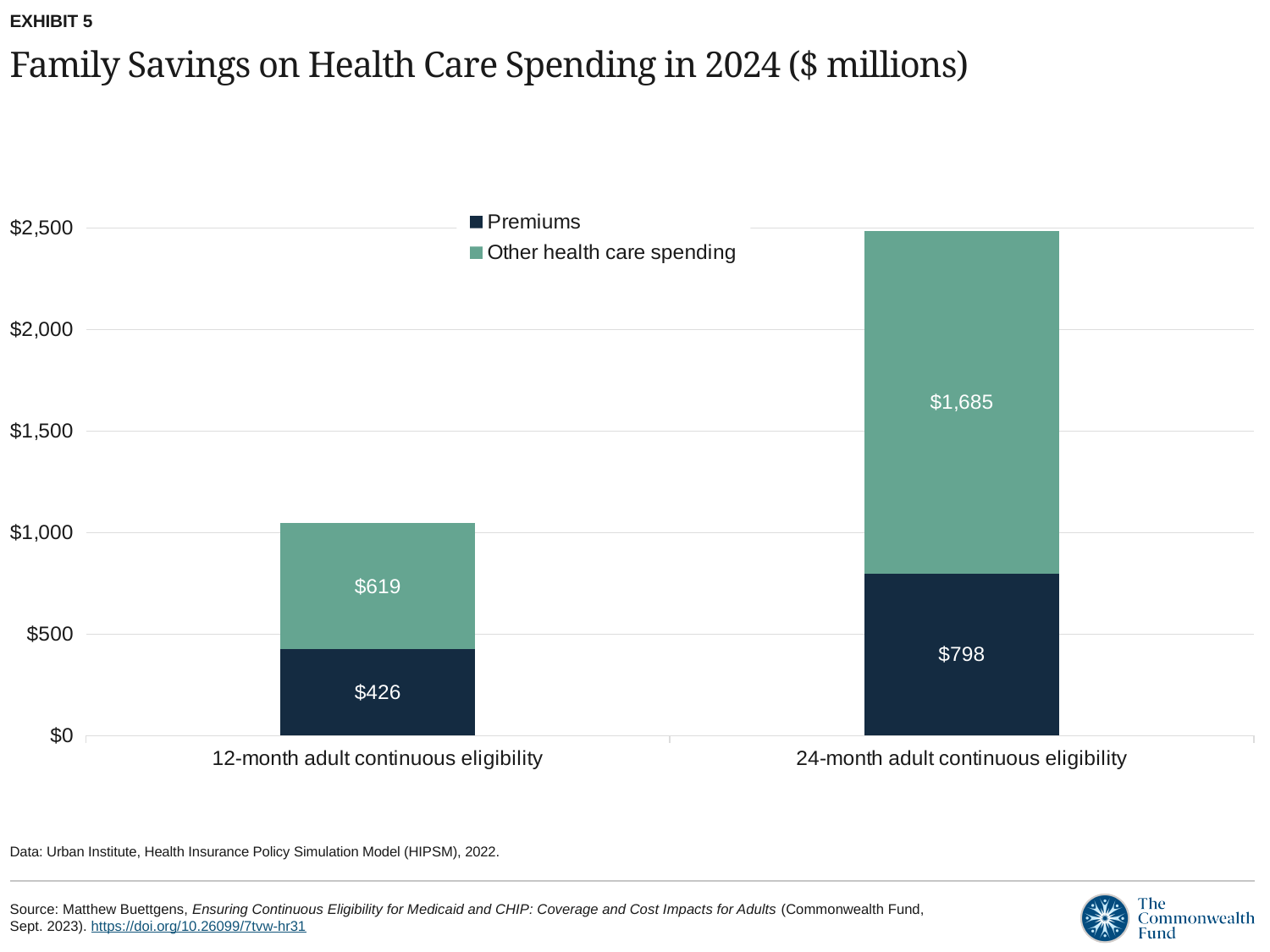
What is the Premiums value for 12-month adult continuous eligibility? $426 Which colour represents Premiums in the chart? Dark navy blue What is the total family savings for 24-month adult continuous eligibility? $2,483 What is the Other health care spending value for 12-month adult continuous eligibility? $619 What is the difference in Premiums savings between 24-month and 12-month adult continuous eligibility? $372 What is the Premiums value for 24-month adult continuous eligibility? $798 Which category has the higher Other health care spending savings? 24-month adult continuous eligibility What is the Other health care spending value for 24-month adult continuous eligibility? $1,685 What is the total family savings for 12-month adult continuous eligibility? $1,045 How many series does the legend list? 2 Is the Premiums value for 12-month adult continuous eligibility greater or less than $500? less What kind of chart is shown on the slide? Stacked bar chart